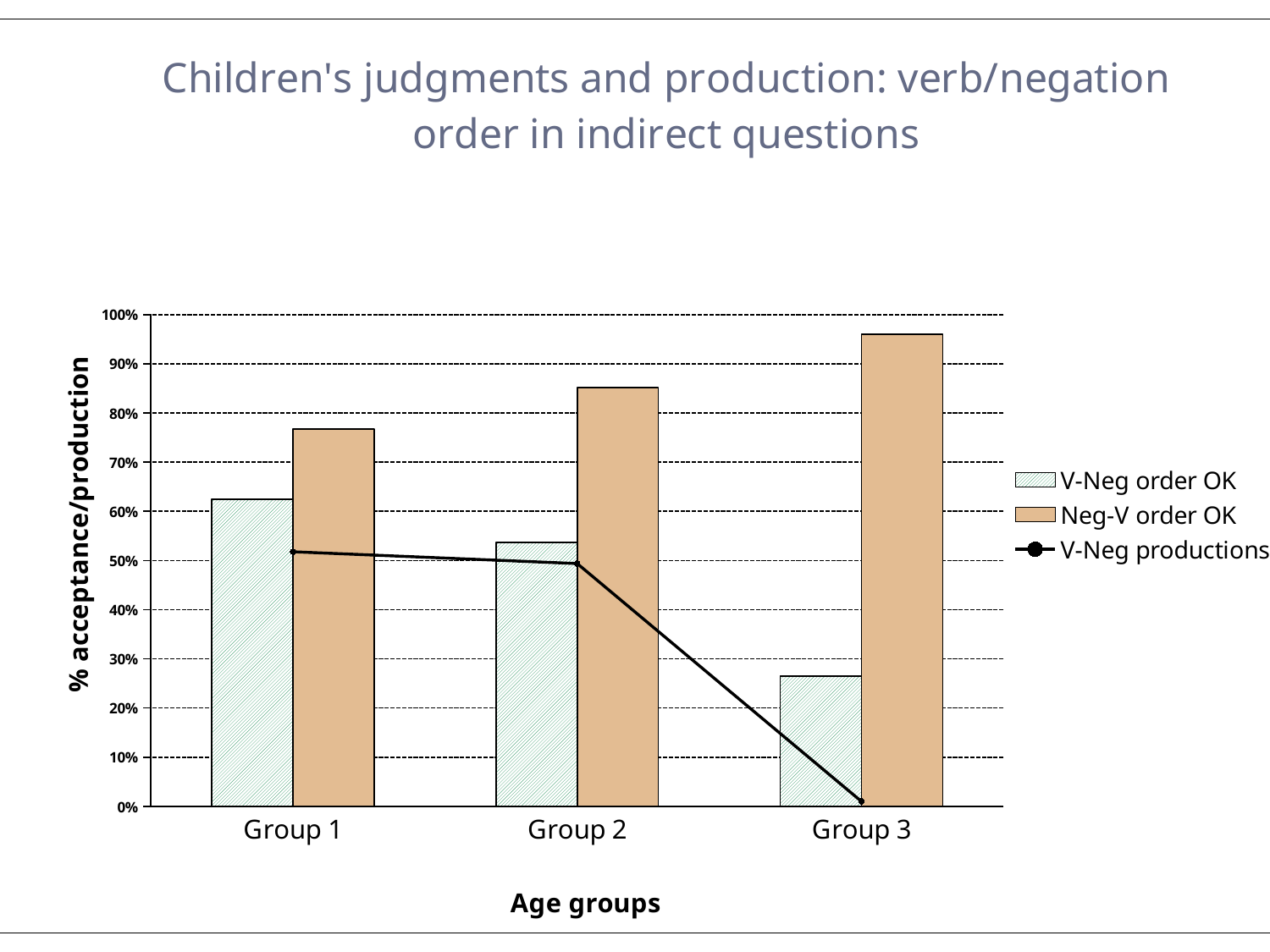
What is the label of the y axis? % acceptance/production Which age group has the lowest value for V-Neg productions? Group 3 Is the value for Neg-V order OK in Group 3 greater or less than 90%? greater Which age group has the highest value for Neg-V order OK? Group 3 Is the value for V-Neg order OK in Group 1 greater or less than 60%? greater How many age groups are shown on the x axis? 3 Which age group has the lowest value for V-Neg order OK? Group 3 Is the value for V-Neg order OK in Group 3 greater or less than 30%? less What kind of chart is shown on the slide? A bar chart combined with a line How many series does the legend list? 3 Do the values for V-Neg productions rise or fall from Group 1 to Group 3? fall In Group 2, which is larger: V-Neg order OK or Neg-V order OK? Neg-V order OK